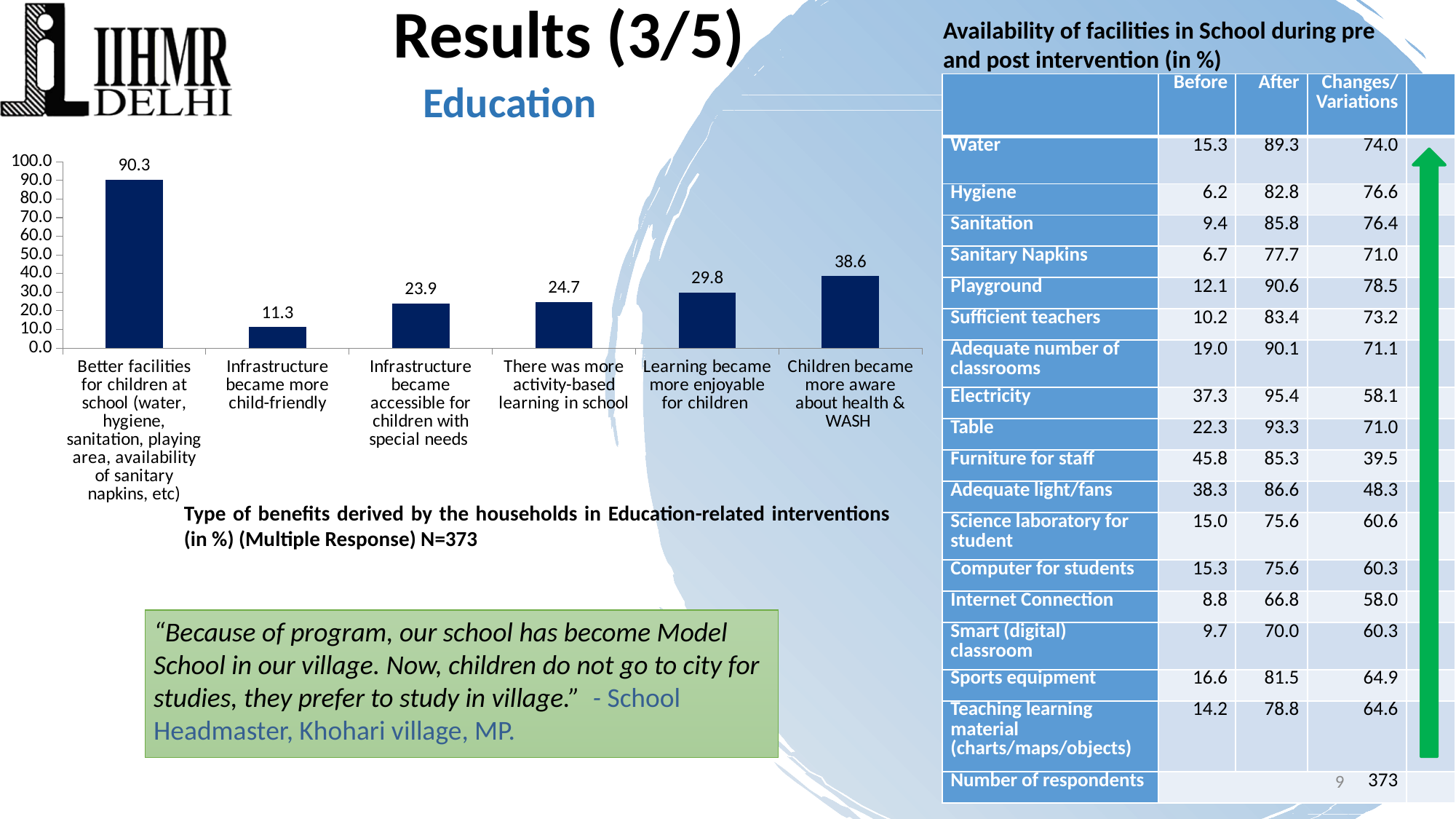
What type of chart is shown on the slide? bar chart What is the difference between the values for 'Better facilities for children at school' and 'Children became more aware about health & WASH'? 51.7 Which category has the highest value in the bar chart? Better facilities for children at school (water, hygiene, sanitation, playing area, availability of sanitary napkins, etc) How many categories are plotted in the bar chart? 6 What is the value for 'There was more activity-based learning in school'? 24.7 Which category has the lowest value in the bar chart? Infrastructure became more child-friendly Is the value for 'Infrastructure became accessible for children with special needs' greater or less than 30.0? less What is the value for 'Infrastructure became more child-friendly'? 11.3 What is the value for 'Learning became more enjoyable for children'? 29.8 What is the N (number of respondents) stated in the bar chart's caption? 373 What is the value for 'Children became more aware about health & WASH'? 38.6 Which is larger: the value for 'Infrastructure became accessible for children with special needs' or the value for 'Learning became more enjoyable for children'? Learning became more enjoyable for children